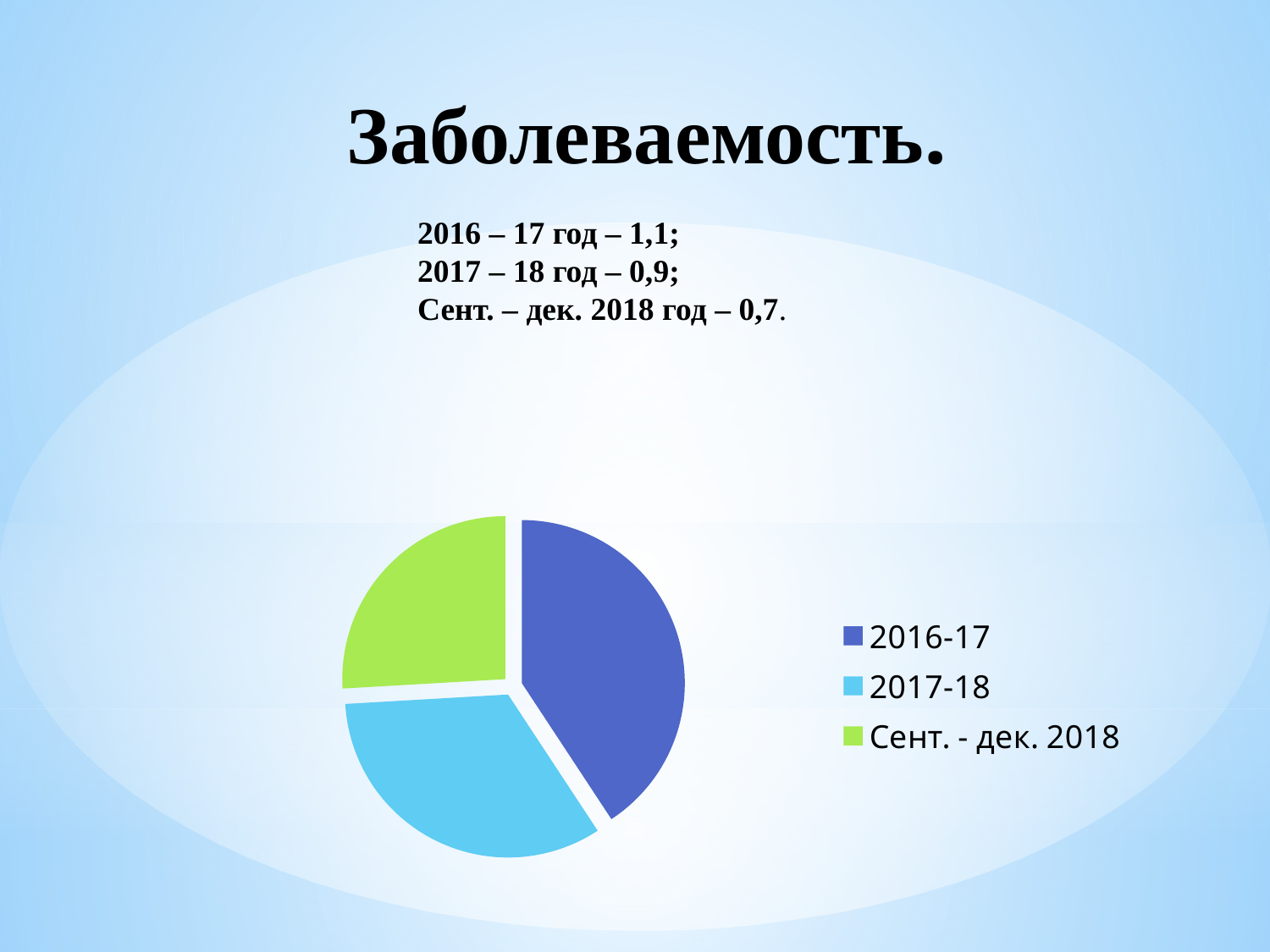
Which slice is larger in the pie chart: 2016-17 or 2017-18? 2016-17 What is the title of the slide with the pie chart? Заболеваемость. Which category has the largest slice in the pie chart? 2016-17 According to the text on the slide, what is the value for 2016 – 17 год? 1,1 According to the text on the slide, what is the value for 2017 – 18 год? 0,9 Which slice is larger in the pie chart: 2017-18 or Сент. - дек. 2018? 2017-18 According to the text on the slide, what is the value for Сент. – дек. 2018 год? 0,7 Which category has the smallest slice in the pie chart? Сент. - дек. 2018 How many slices does the pie chart have? 3 What kind of chart is shown on the slide? pie chart How many entries does the legend of the pie chart list? 3 What colour is the slice for Сент. - дек. 2018 in the pie chart? green